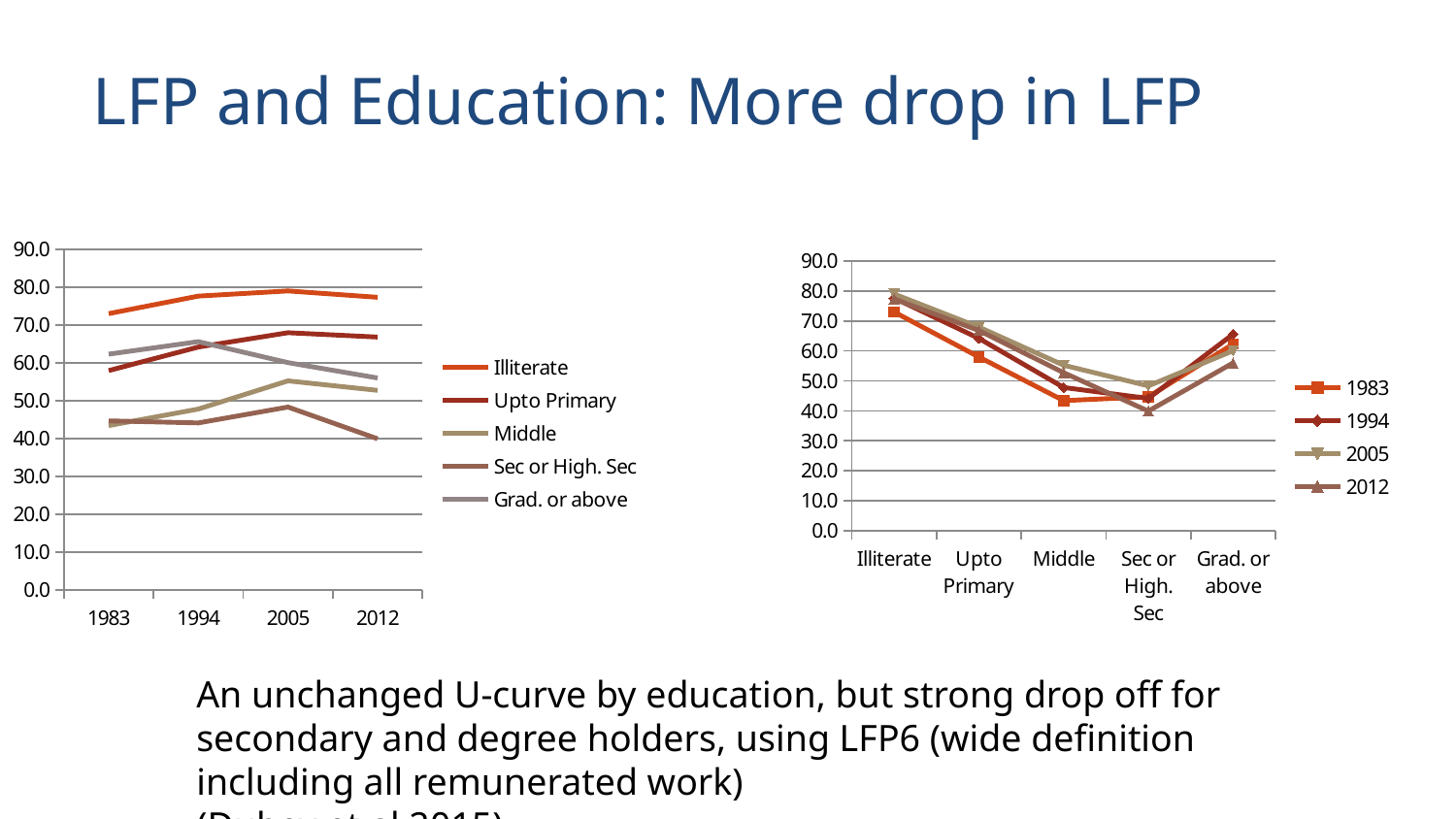
In the right chart, is the value for 1983 at Middle greater or less than 50? less In the right chart, which education category has the highest values for all years? Illiterate In the left chart, does the Grad. or above series rise or fall between 1994 and 2012? fall In the left chart, is the value for Illiterate in 2005 greater or less than 70? greater How many series does the legend of the right chart list? 4 How many education categories are shown on the x axis of the right chart? 5 In the left chart, is the value for Sec or High. Sec in 2012 greater or less than 50? less How many series does the legend of the left chart list? 5 How many years are shown on the x axis of the left chart? 4 In the left chart, which series has the lowest value in 2012? Sec or High. Sec What type of chart is the chart on the left of the slide? line chart In the left chart, which series has the highest values across all years? Illiterate